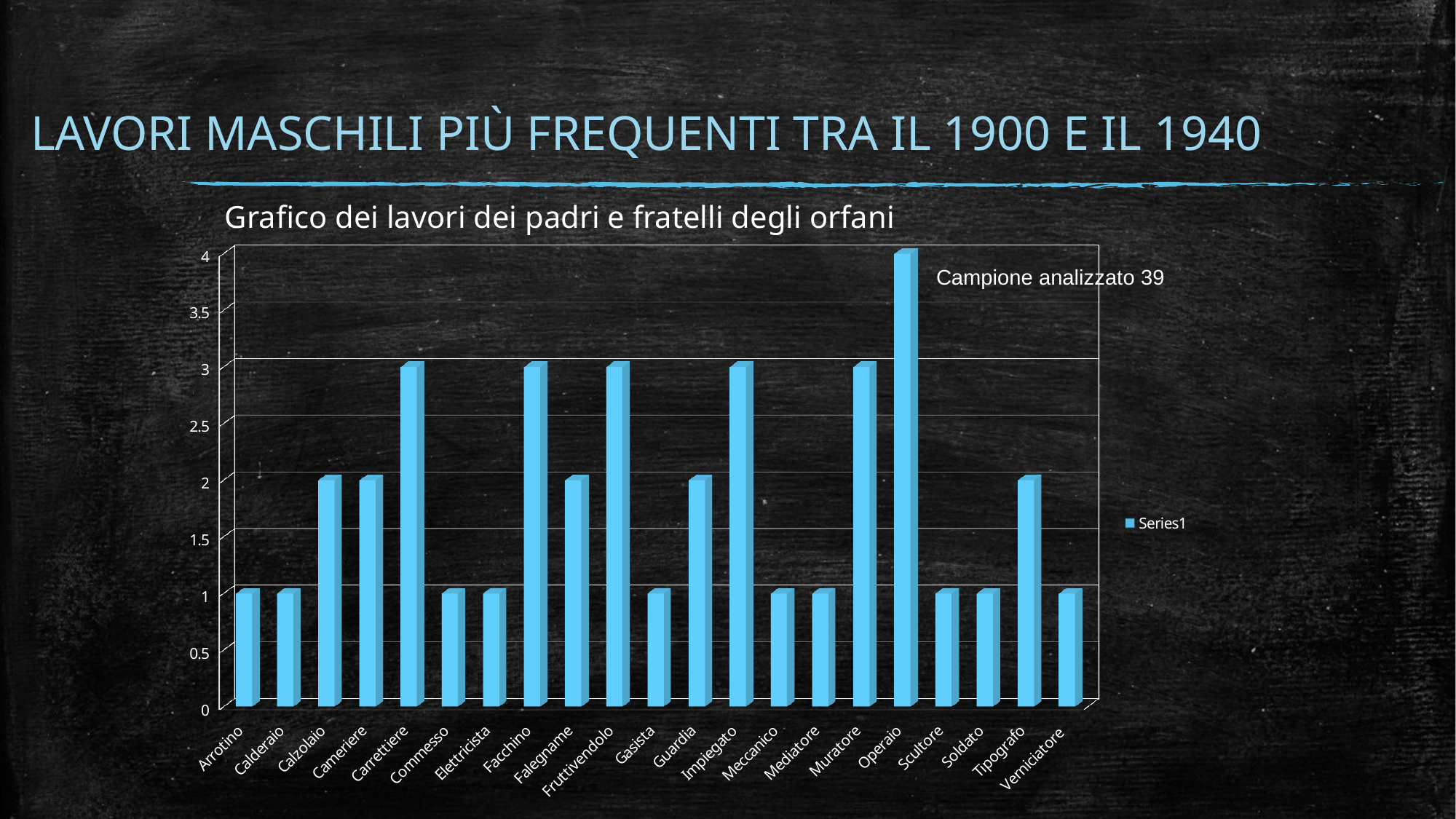
What kind of chart is shown on the slide? Bar chart How many categories are shown on the x axis of the chart? 21 What is the value for Operaio? 4 What is the value for Verniciatore? 1 What is the value for Carrettiere? 3 Which is larger, the value for Muratore or the value for Meccanico? Muratore What is the difference between the values for Operaio and Calzolaio? 2 How many series does the chart legend list? 1 Which category has the highest value in the chart? Operaio What is the title of the chart? Grafico dei lavori dei padri e fratelli degli orfani Is the value for Impiegato greater or less than 2? greater What is the value for Tipografo? 2